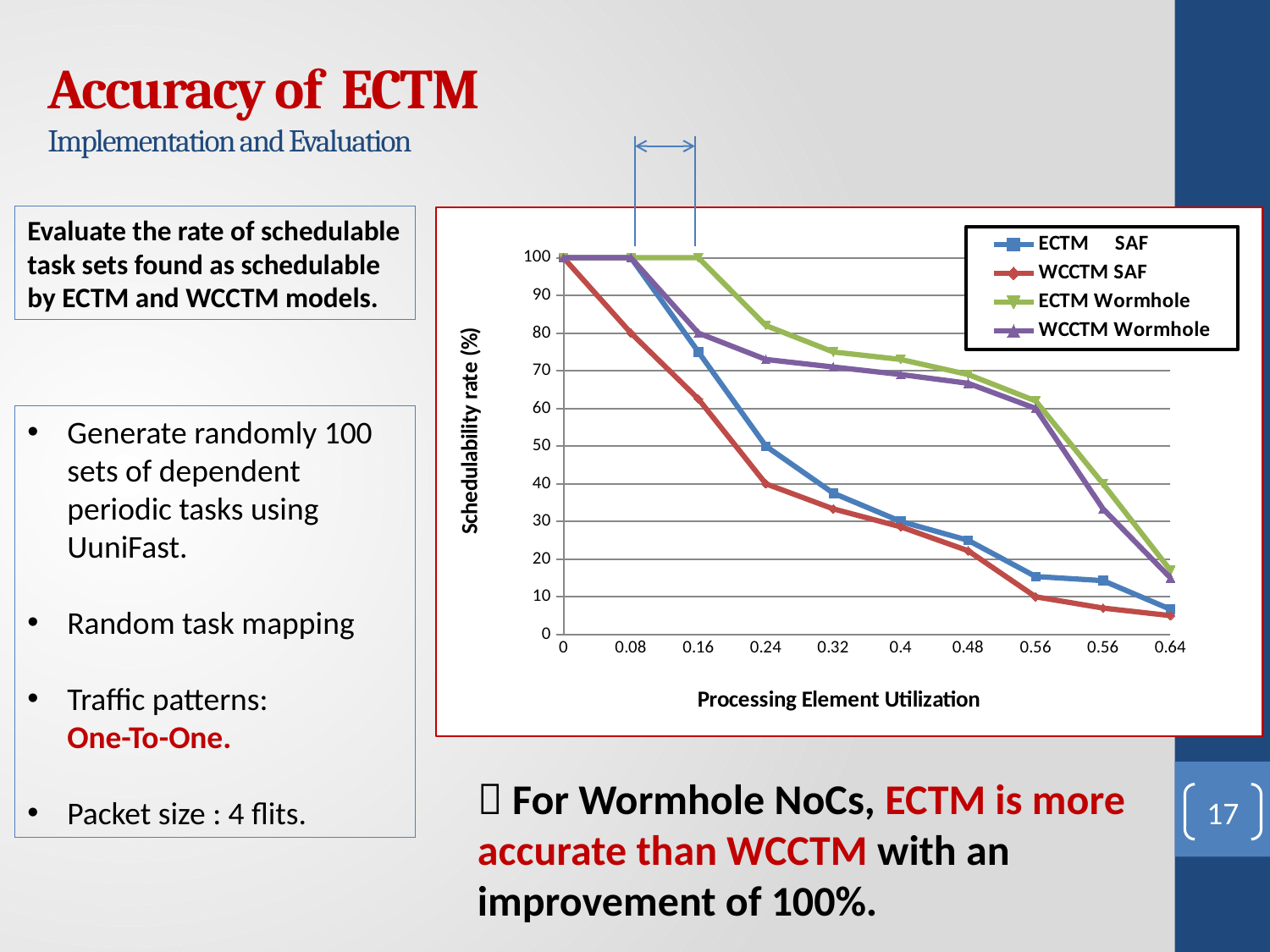
What kind of chart is shown on the slide? line chart What is the schedulability rate for ECTM Wormhole at a utilization of 0.16? 100 What is the title of the x axis of the chart? Processing Element Utilization How many utilization values are marked along the x axis of the chart? 10 What is the schedulability rate for WCCTM SAF at a utilization of 0.08? 80 Is the value for WCCTM SAF at a utilization of 0.64 greater or less than 10? less Is the value for ECTM Wormhole at a utilization of 0.64 greater or less than 20? less Does the schedulability rate for ECTM SAF rise or fall as processing element utilization increases? fall At a utilization of 0.24, which series has the highest schedulability rate? ECTM Wormhole What is the title of the y axis of the chart? Schedulability rate (%) How many series does the chart legend list? 4 At a utilization of 0.16, which series has the higher schedulability rate, ECTM Wormhole or WCCTM Wormhole? ECTM Wormhole